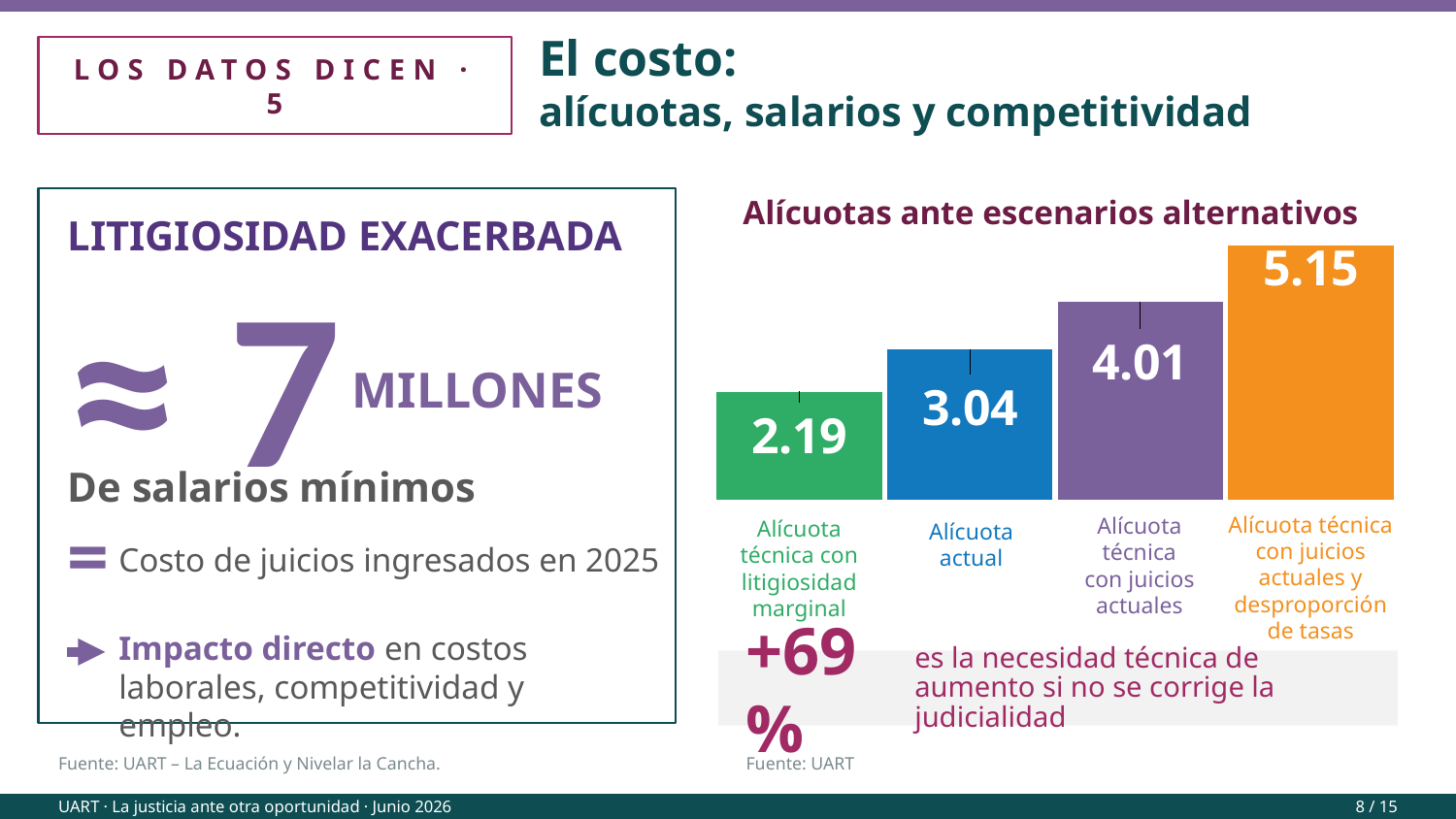
What is the value for 'Alícuota actual' in the chart 'Alícuotas ante escenarios alternativos'? 3.04 What is the value for 'Alícuota técnica con juicios actuales y desproporción de tasas'? 5.15 Do the values rise or fall from left to right across the bars? Rise How many bars are shown in the chart 'Alícuotas ante escenarios alternativos'? 4 Which category has the highest value in the chart? Alícuota técnica con juicios actuales y desproporción de tasas What is the value for 'Alícuota técnica con litigiosidad marginal'? 2.19 Which is larger, 'Alícuota actual' or 'Alícuota técnica con litigiosidad marginal'? Alícuota actual What is the value for 'Alícuota técnica con juicios actuales'? 4.01 What kind of chart is 'Alícuotas ante escenarios alternativos'? Bar chart Which category has the lowest value in the chart? Alícuota técnica con litigiosidad marginal What is the difference between 'Alícuota técnica con juicios actuales' and 'Alícuota actual'? 0.97 What is the difference between the highest and lowest bars in the chart? 2.96